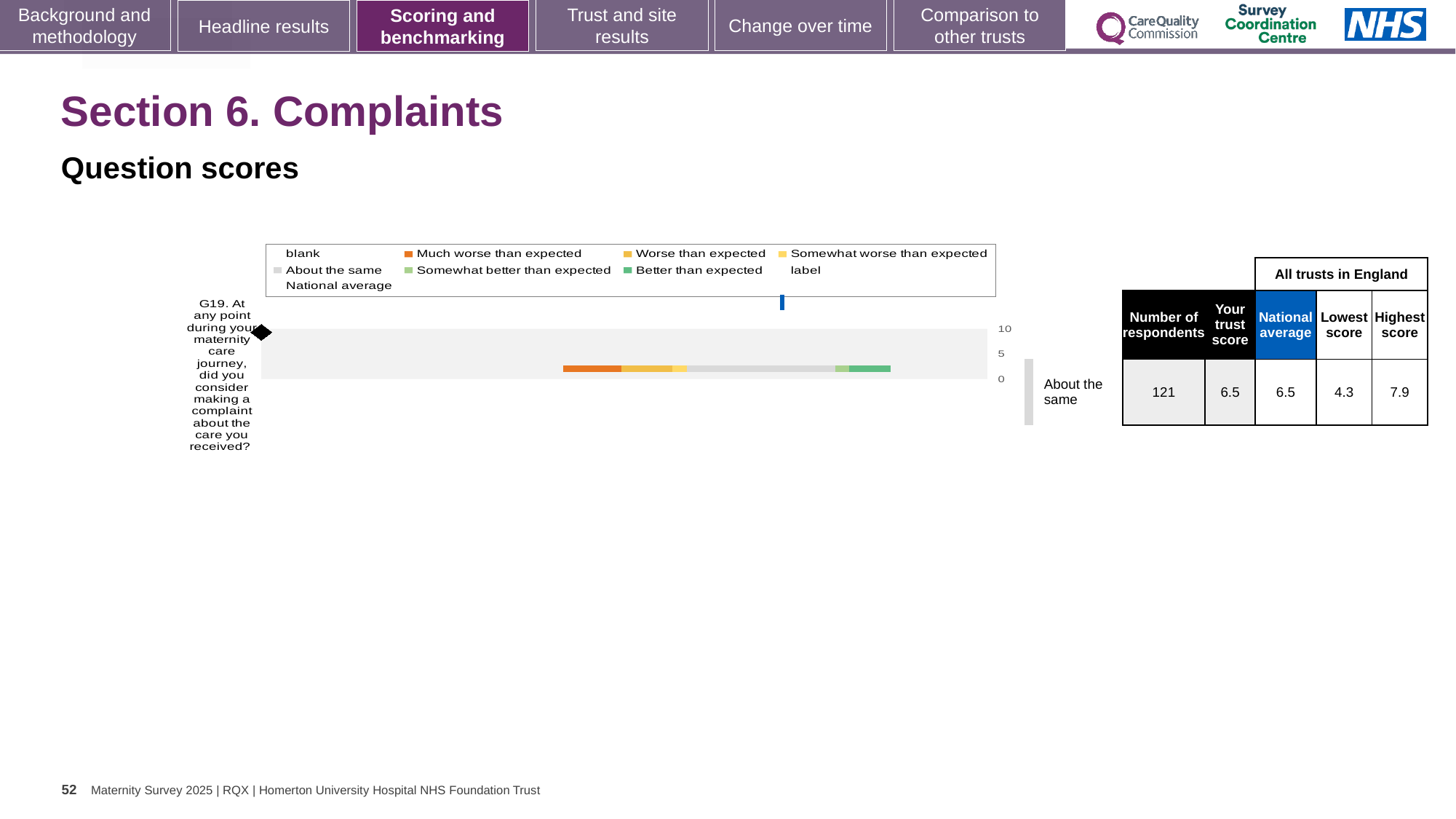
Which question is plotted in the chart? G19. At any point during your maternity care journey, did you consider making a complaint about the care you received? What is the lowest score among all trusts in England for question G19? 4.3 What is the highest tick value shown on the chart's axis? 10 Is the trust score for question G19 greater or less than 5? greater What is the national average score for question G19? 6.5 How is the trust's result for question G19 categorised relative to expectations? About the same What is the difference between the highest and lowest scores for question G19? 3.6 How many survey questions are plotted in the chart? 1 What kind of chart is shown on the slide? bar chart What is the highest score among all trusts in England for question G19? 7.9 How many respondents answered question G19? 121 What is the trust score for question G19? 6.5